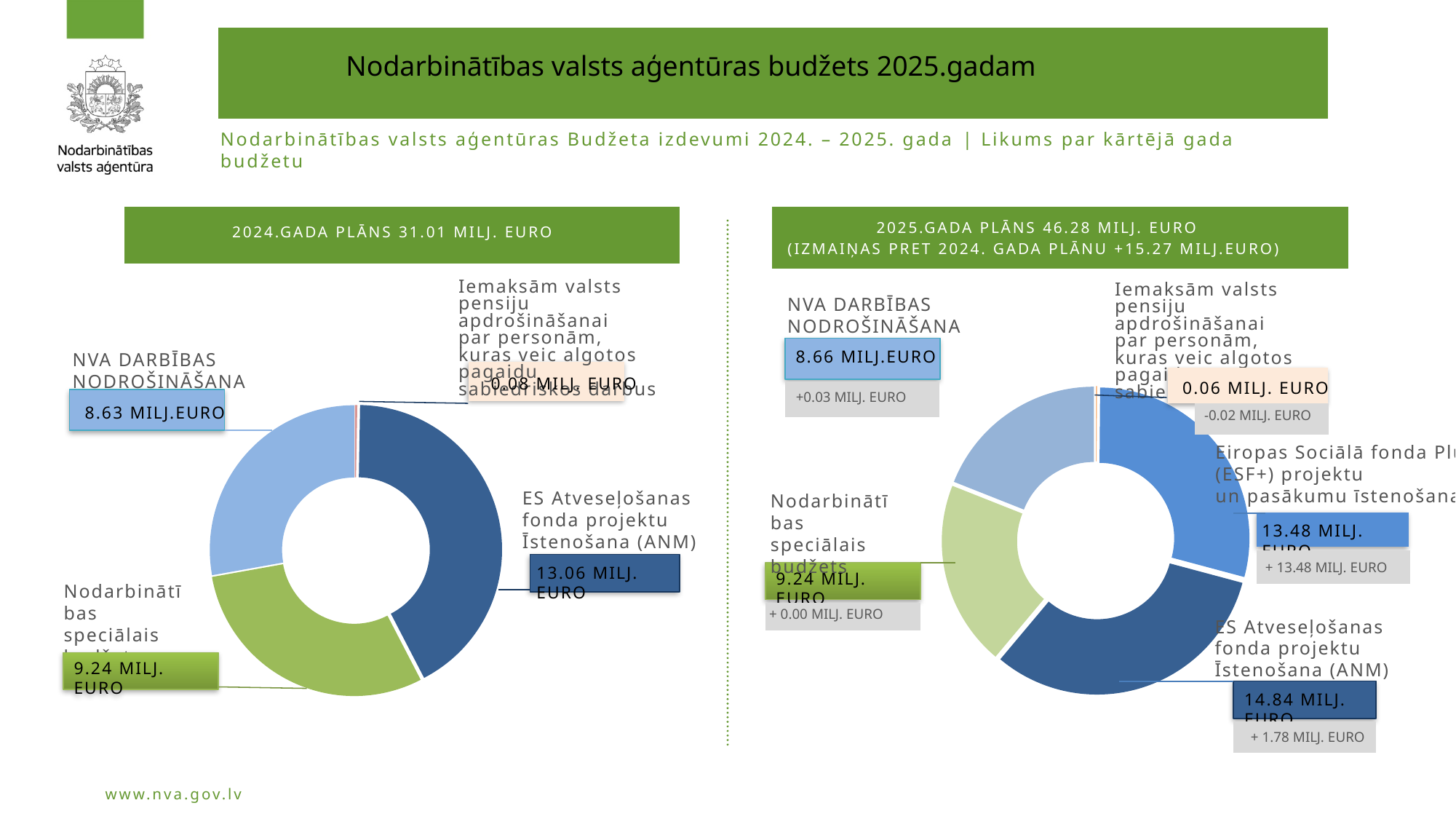
In the 2025 plan chart (right), which is larger: ES Atveseļošanas fonda (ANM) or ESF+ projektu īstenošana? ES Atveseļošanas fonda (ANM) In the 2024 plan chart (left), which category has the largest value? ES Atveseļošanas fonda projektu īstenošana (ANM) What kind of chart is used for the 2024 plan (left)? Donut (pie) chart In the 2024 plan chart (left), what is the difference between ES Atveseļošanas fonda (ANM) and NVA darbības nodrošināšana? 4.43 MILJ. EURO In the 2025 plan chart (right), what is the change versus the 2024 plan shown for NVA darbības nodrošināšana? +0.03 MILJ. EURO In the 2024 plan chart (left), what is the value for NVA darbības nodrošināšana? 8.63 MILJ.EURO In the 2025 plan chart (right), what is the value for Eiropas Sociālā fonda Plus (ESF+) projektu un pasākumu īstenošana? 13.48 MILJ. EURO How many categories does the 2024 plan chart (left) show? 4 How many categories does the 2025 plan chart (right) show? 5 In the 2025 plan chart (right), which category has the smallest value? Iemaksām valsts pensiju apdrošināšanai In the 2025 plan chart (right), what is the value for ES Atveseļošanas fonda projektu īstenošana (ANM)? 14.84 MILJ. EURO In the 2024 plan chart (left), what is the value for ES Atveseļošanas fonda projektu īstenošana (ANM)? 13.06 MILJ. EURO